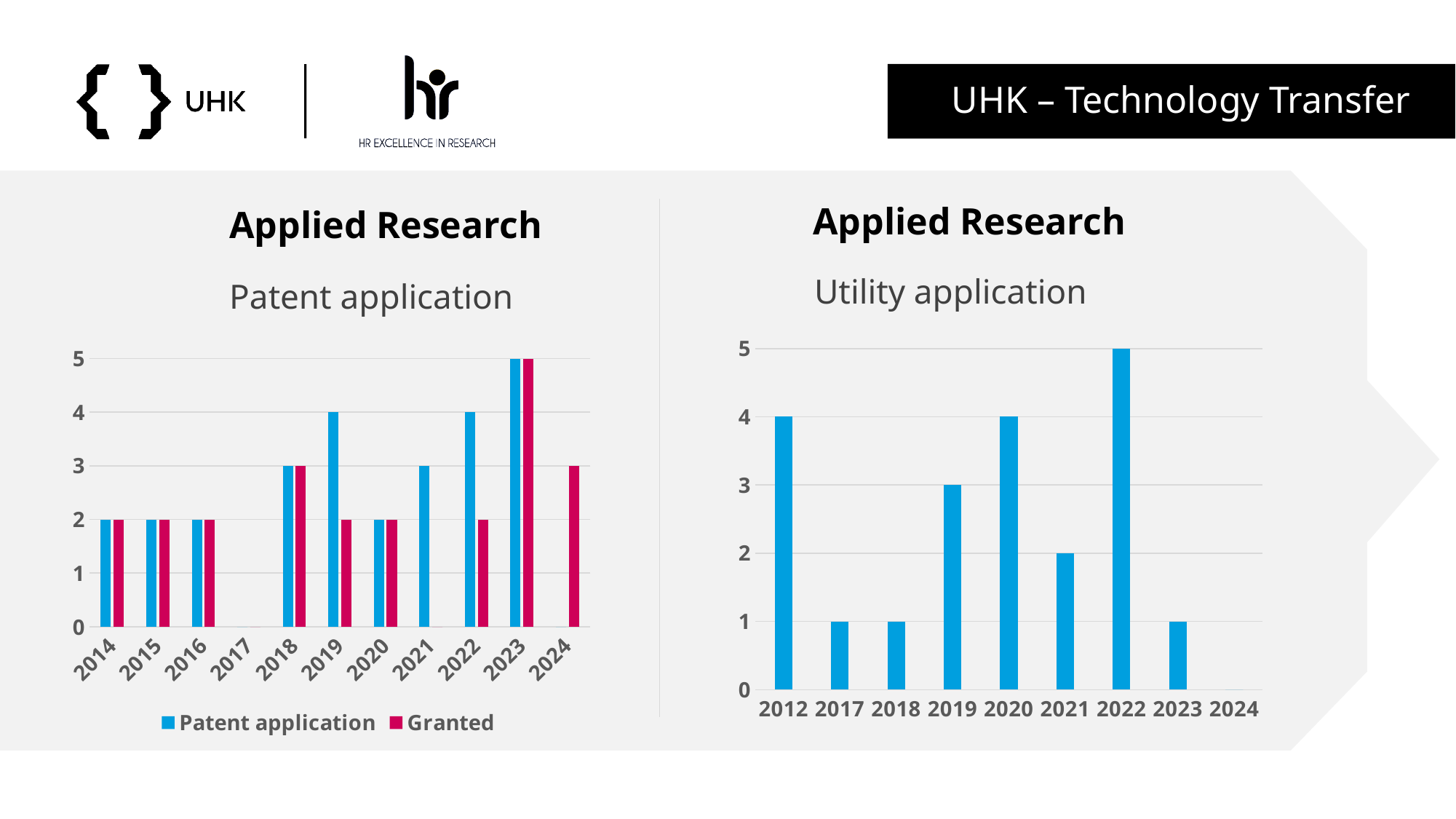
In the Patent application chart, what is the difference between Patent application and Granted in 2022? 2 In the Utility application chart, what is the value for 2022? 5 In the Patent application chart, which series is shown in blue? Patent application In the Patent application chart, which year has the highest Patent application value? 2023 In the Utility application chart, what is the value for 2019? 3 In the Patent application chart, what is the value of Granted for 2024? 3 In the Utility application chart, which year has the highest value? 2022 In the Patent application chart, how many series does the legend list? 2 In the Utility application chart, is the value for 2012 larger than the value for 2021? Yes In the Patent application chart, what is the value of Granted for 2019? 2 What kind of chart is the Utility application chart? Bar chart In the Patent application chart, what is the value of Patent application for 2023? 5